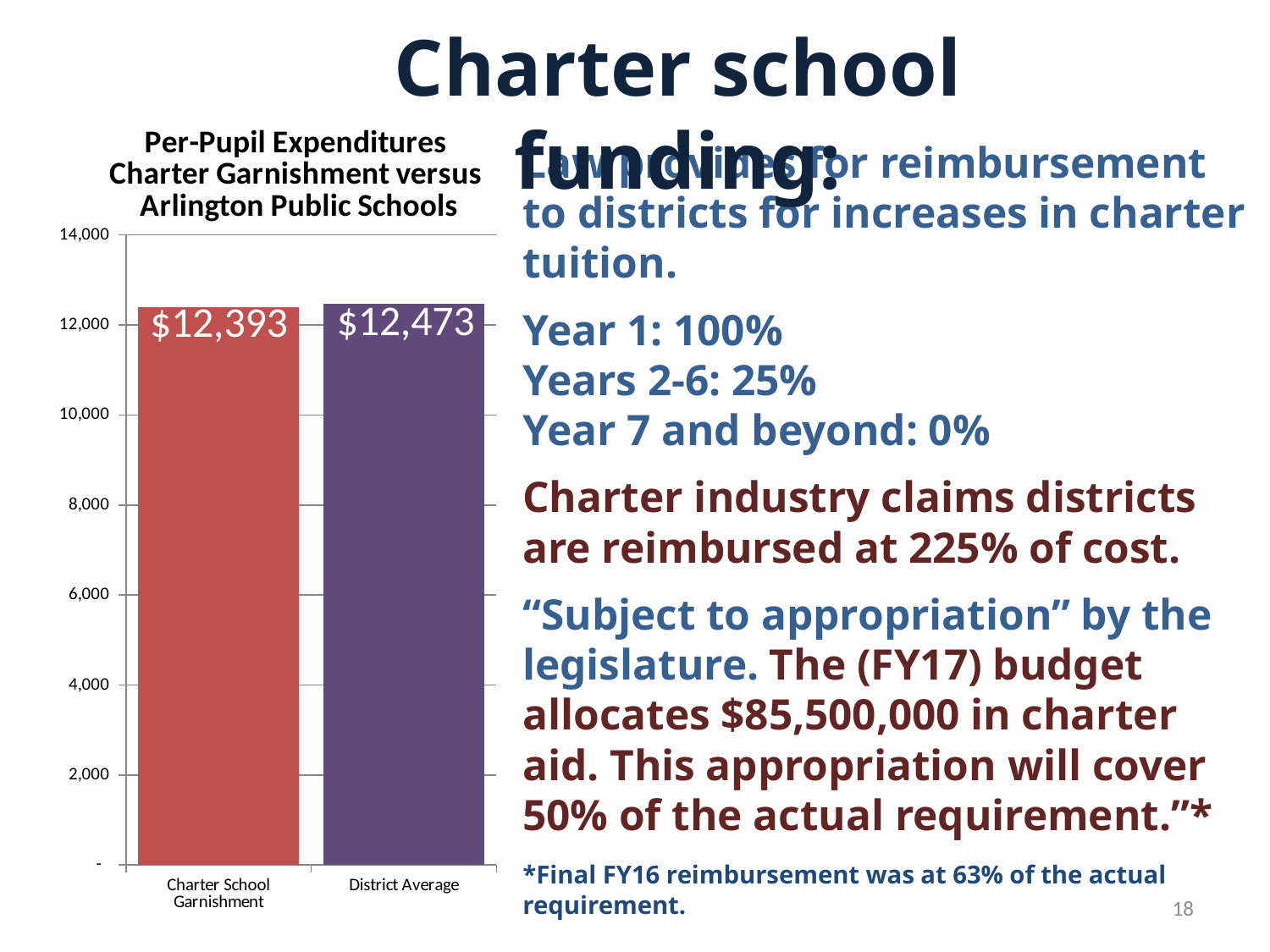
What is the per-pupil expenditure value for Charter School Garnishment? $12,393 What type of chart is shown on the slide? Bar chart What is the title of the chart? Per-Pupil Expenditures Charter Garnishment versus Arlington Public Schools What is the difference between the District Average and Charter School Garnishment values? $80 How many categories are shown in the chart? 2 Which category has the lowest value in the chart? Charter School Garnishment Is the value for Charter School Garnishment greater or less than 12,000? greater Is the value for District Average greater or less than 14,000? less What is the per-pupil expenditure value for District Average? $12,473 What colour is the bar for District Average? Purple Which category has the higher per-pupil expenditure, Charter School Garnishment or District Average? District Average What is the highest value shown on the y-axis of the chart? 14,000